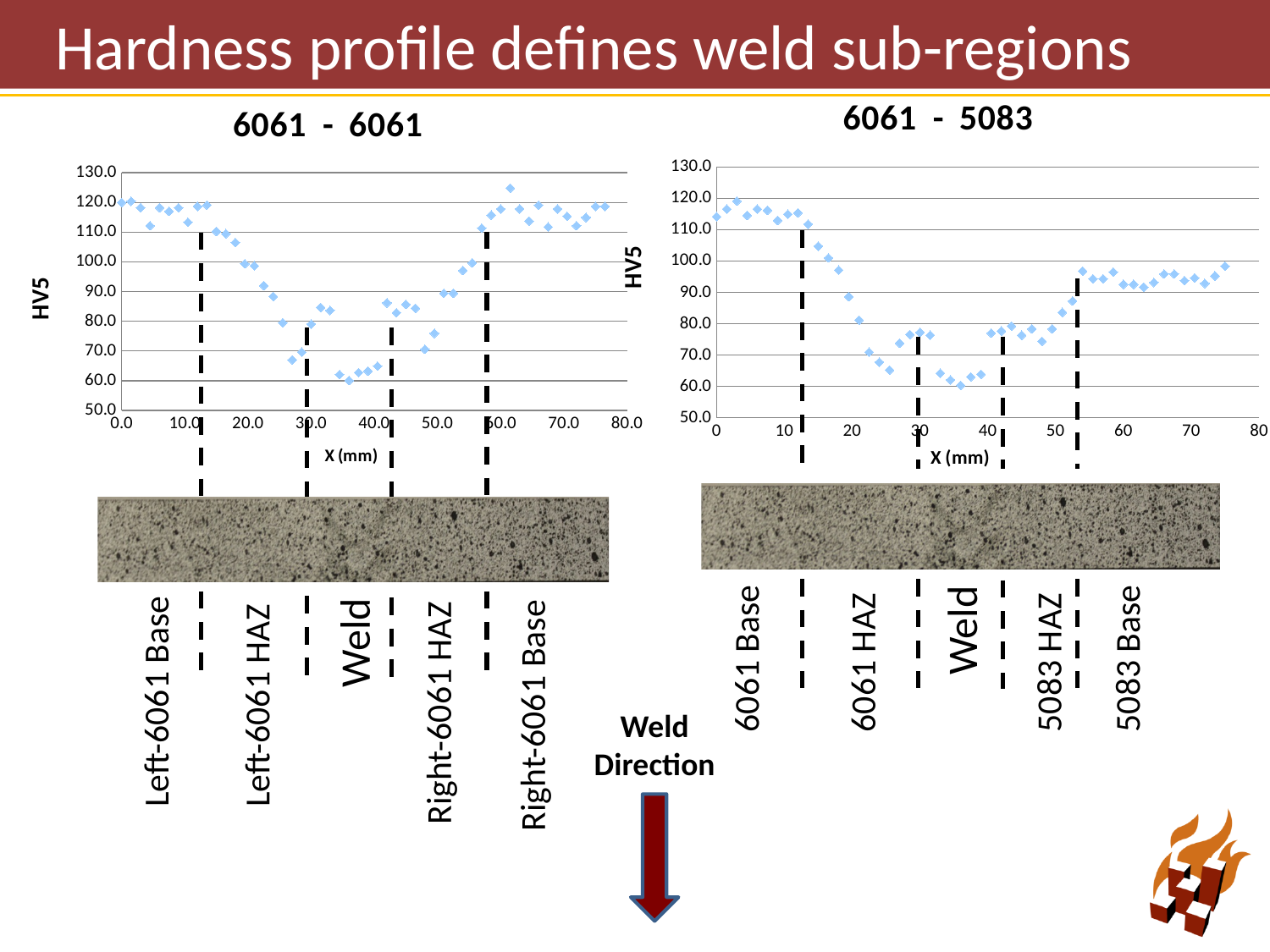
In the "6061 - 6061" chart, do the values rise or fall as X increases from 0 to about 36 mm? fall In the "6061 - 6061" chart, which is larger: the value at X = 0.0 mm or the value at X = 36 mm? X = 0.0 mm In the "6061 - 6061" chart, is the lowest value near X = 36 mm greater or less than 70? less What kind of chart is the "6061 - 6061" chart? Scatter chart In the "6061 - 5083" chart, is the value at X = 60 mm greater or less than 100? less How many charts are shown on the slide? 2 In the "6061 - 5083" chart, which labelled sub-region contains the lowest hardness values? Weld In the "6061 - 5083" chart, is the value at X = 5 mm greater or less than 100? greater What is the title of the chart on the right side of the slide? 6061 - 5083 What is the y-axis label on the "6061 - 6061" chart? HV5 In the "6061 - 5083" chart, do the values rise or fall as X increases from about 40 to 55 mm? rise